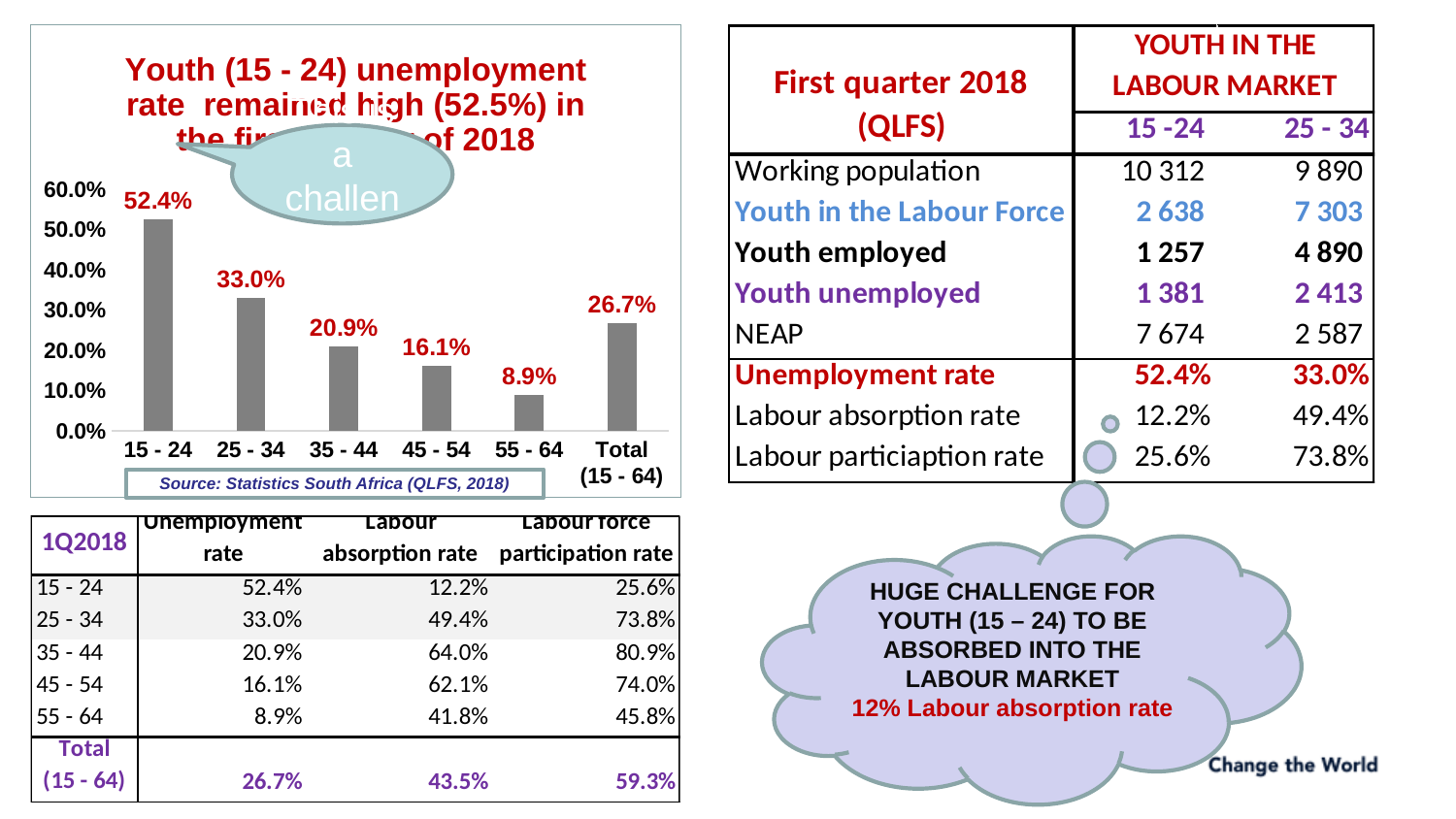
What type of chart is used to show the unemployment rates by age group? Bar chart Which age group has the highest unemployment rate in the bar chart? 15 - 24 How many categories are plotted along the x axis of the bar chart? 6 Is the value for the 25 - 34 age group in the bar chart greater or less than 30.0%? greater What is the unemployment rate shown for the 15 - 24 age group in the bar chart? 52.4% What is the difference between the unemployment rates for the 15 - 24 and 25 - 34 age groups in the bar chart? 19.4% Which category has the lowest value in the bar chart? 55 - 64 What source is cited beneath the bar chart? Statistics South Africa (QLFS, 2018) Do the values in the bar chart rise or fall from the 15 - 24 group to the 55 - 64 group? Fall In the bar chart, which is larger: the value for 45 - 54 or the value for 55 - 64? 45 - 54 What value does the bar chart show for the Total (15 - 64) category? 26.7% What is the unemployment rate shown for the 35 - 44 age group in the bar chart? 20.9%